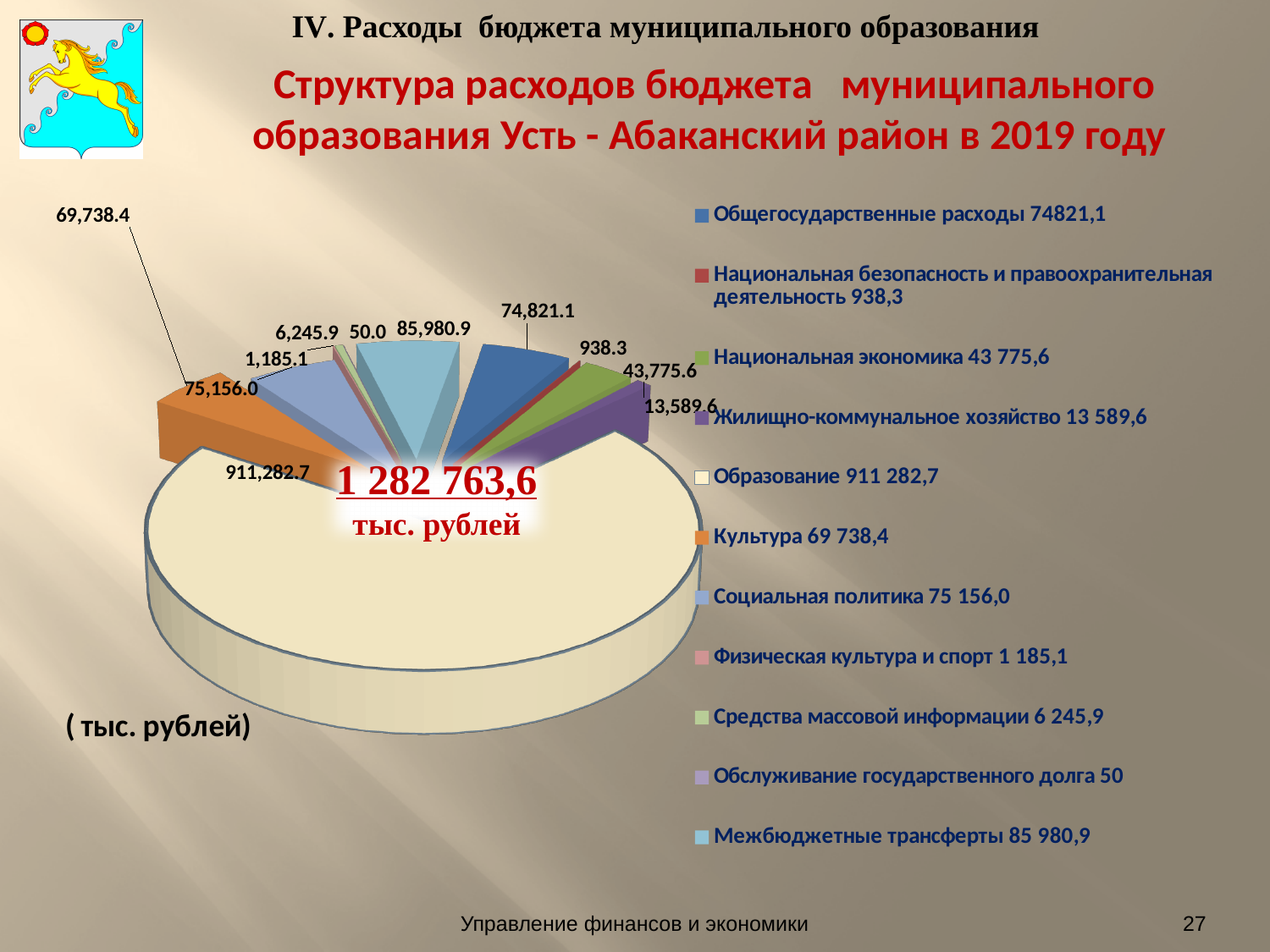
What year does the chart title say the budget expenditure structure is for? 2019 Which category has the smallest value? Обслуживание государственного долга Which category has the largest slice of the pie? Образование What is the value for Национальная безопасность и правоохранительная деятельность? 938.3 What kind of chart is shown on the slide? pie chart What is the value for Жилищно-коммунальное хозяйство? 13,589.6 How many categories does the pie chart have? 11 What total is printed in the centre of the pie chart? 1 282 763,6 тыс. рублей What is the value for Образование? 911,282.7 Which is larger, Межбюджетные трансферты or Общегосударственные расходы? Межбюджетные трансферты What is the difference between Социальная политика and Культура? 5,417.6 What is the value for Межбюджетные трансферты? 85,980.9